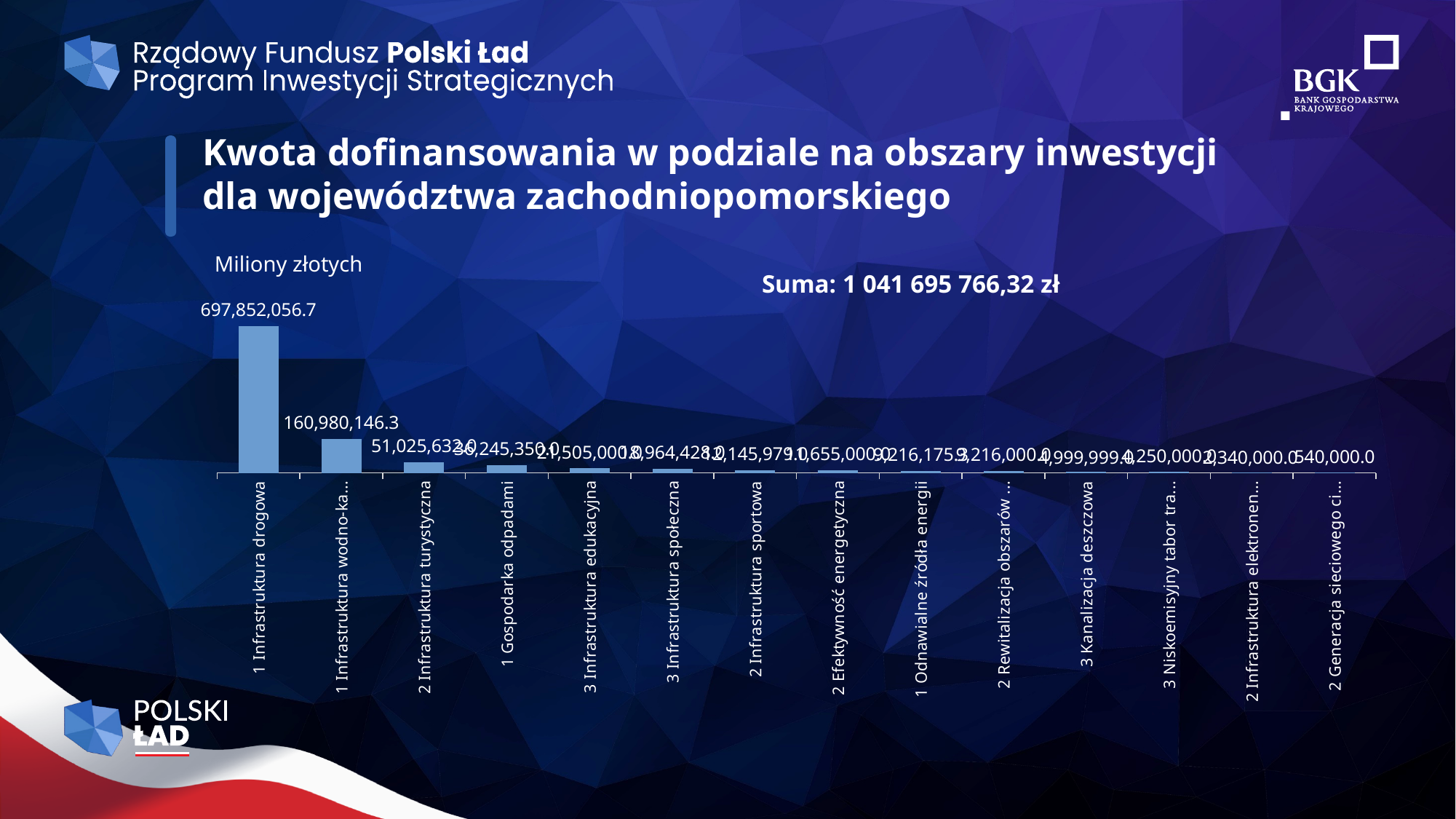
What is the difference between the values for 1 Infrastruktura drogowa and 1 Infrastruktura wodno-ka...? 536,871,910.4 What is the value for 2 Generacja sieciowego ci...? 540,000.0 Which category has the highest value? 1 Infrastruktura drogowa What is the value for 1 Infrastruktura drogowa? 697,852,056.7 What is the value for 1 Gospodarka odpadami? 36,245,350.0 How many categories are shown in the chart? 14 What is the value for 3 Kanalizacja deszczowa? 4,999,999.0 Which category has the lowest value? 2 Generacja sieciowego ci... What total sum (Suma) is stated on the slide? 1 041 695 766,32 zł What is the value for 1 Infrastruktura wodno-ka...? 160,980,146.3 Which is larger, the value for 3 Kanalizacja deszczowa or 3 Niskoemisyjny tabor tra...? 3 Kanalizacja deszczowa What kind of chart is shown on the slide? Bar chart